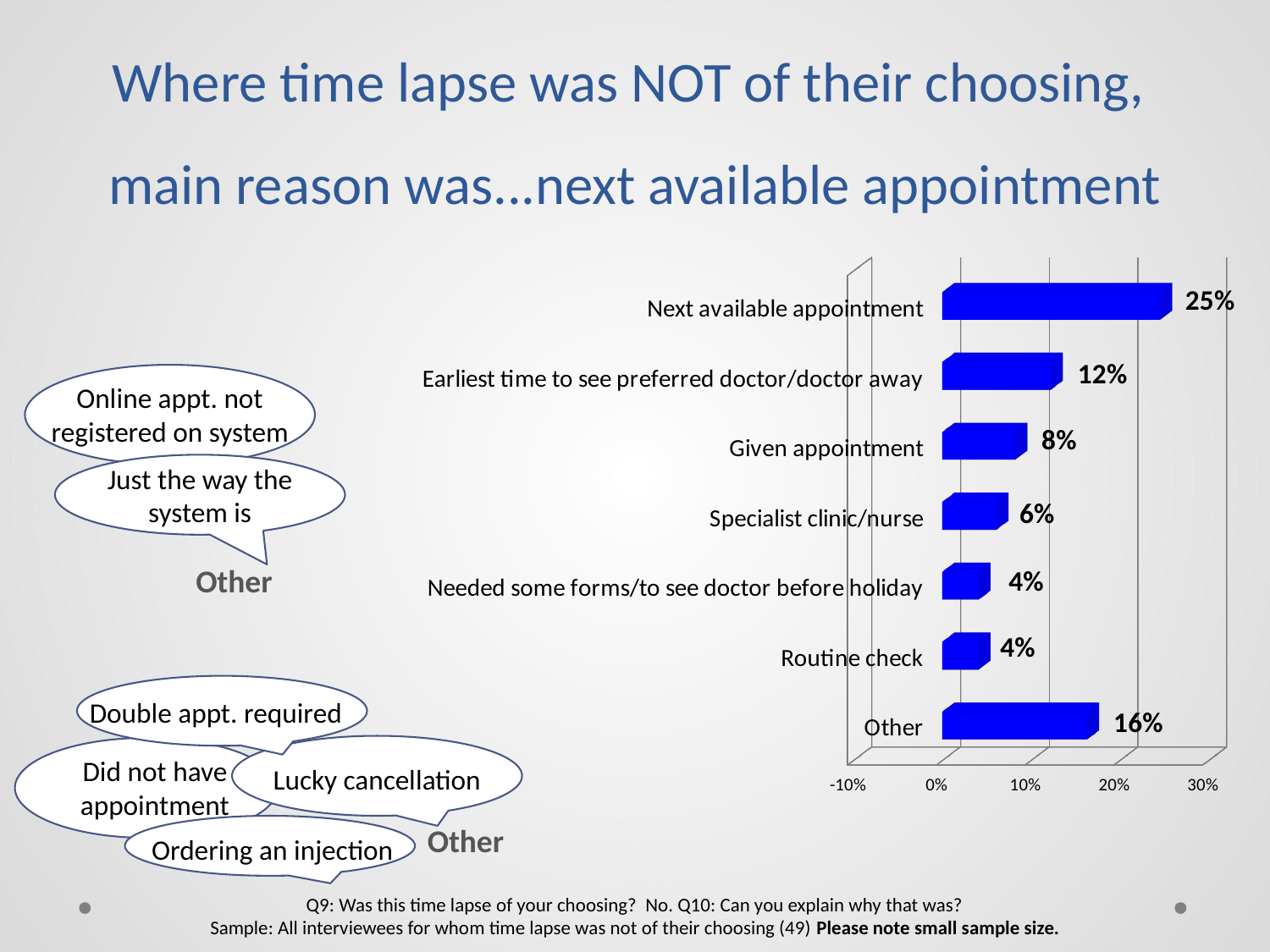
What is the highest value shown on the chart's axis? 30% What percentage is shown for Given appointment? 8% What is the value for Specialist clinic/nurse? 6% Which is larger, Other or Earliest time to see preferred doctor/doctor away? Other What is the value for Earliest time to see preferred doctor/doctor away? 12% What type of chart is shown on the slide? Bar chart Which category has the highest value? Next available appointment How many categories are shown in the chart? 7 What is the difference between Next available appointment and Other? 9% What percentage is shown for Next available appointment? 25% What percentage is shown for Other? 16% What is the difference between Earliest time to see preferred doctor/doctor away and Given appointment? 4%